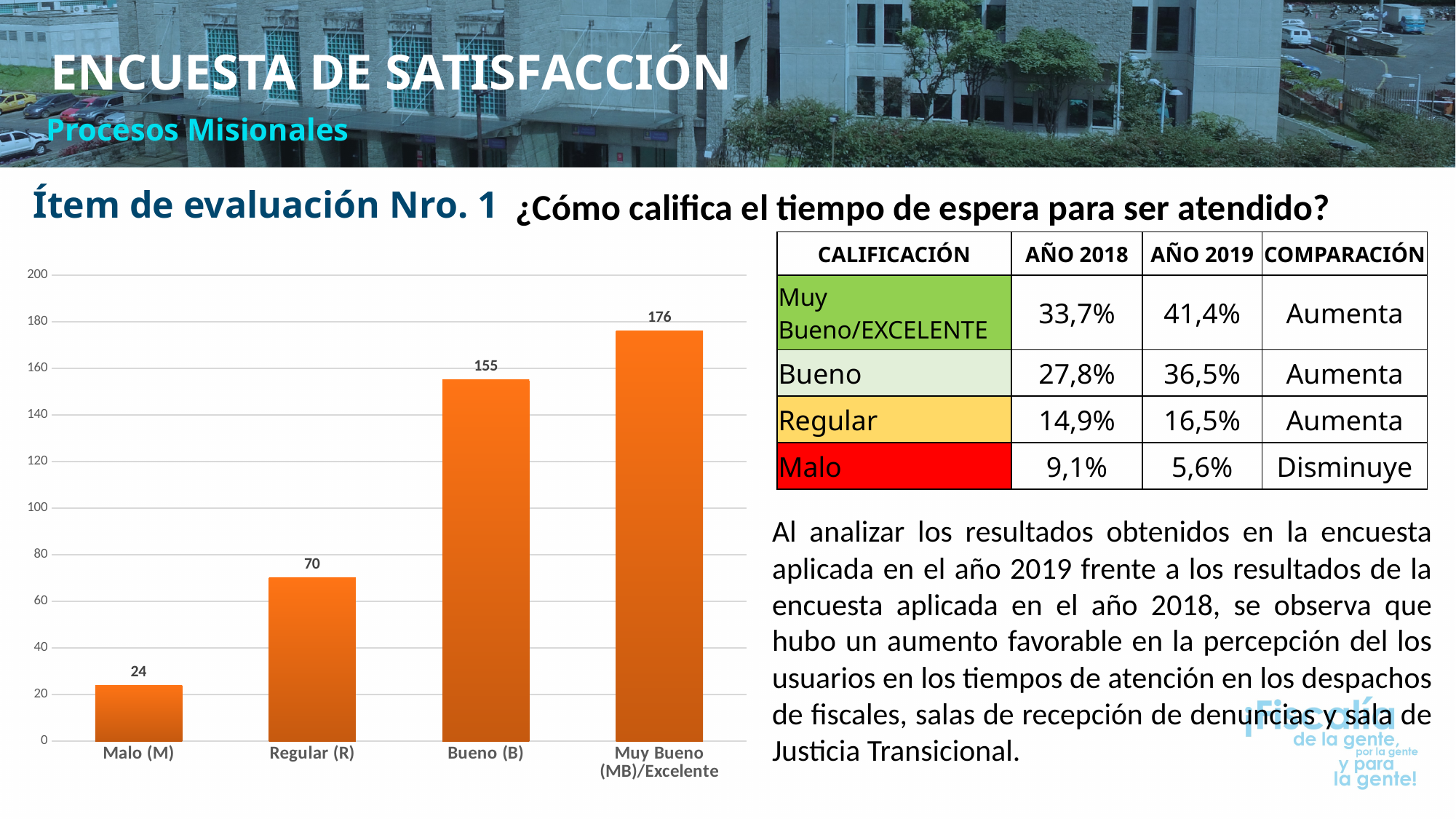
How many categories are shown in the bar chart? 4 Which category has the lowest value in the bar chart? Malo (M) What is the difference between the values for Regular (R) and Malo (M)? 46 What is the value for Regular (R) in the bar chart? 70 What is the value for Bueno (B) in the bar chart? 155 What is the difference between the values for Muy Bueno (MB)/Excelente and Bueno (B)? 21 Which category has the highest value in the bar chart? Muy Bueno (MB)/Excelente What is the value for Malo (M) in the bar chart? 24 Which is larger, the value for Regular (R) or the value for Bueno (B)? Bueno (B) What kind of chart is shown on the slide? Bar chart Do the values rise or fall from left to right along the x axis of the bar chart? Rise What is the value for Muy Bueno (MB)/Excelente in the bar chart? 176